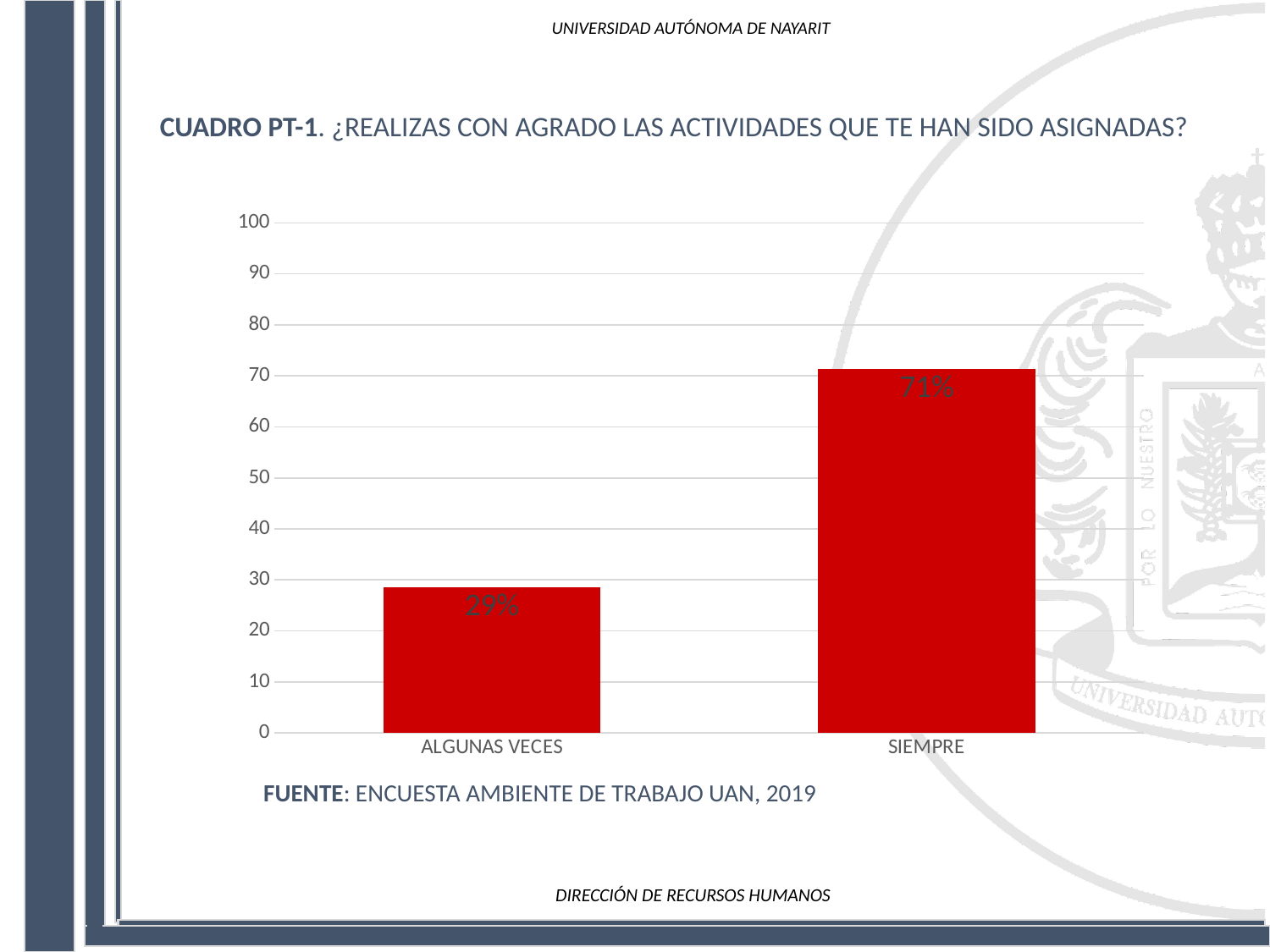
What source is cited below the chart? ENCUESTA AMBIENTE DE TRABAJO UAN, 2019 Which is larger, the value for ALGUNAS VECES or the value for SIEMPRE? SIEMPRE Which category has the lowest value? ALGUNAS VECES Is the value for ALGUNAS VECES greater or less than 40? less What is the difference between the values for SIEMPRE and ALGUNAS VECES? 42% What is the value for ALGUNAS VECES? 29% What kind of chart is shown on the slide? bar chart Which category has the highest value? SIEMPRE Is the value for SIEMPRE greater or less than 50? greater What is the maximum value shown on the vertical axis? 100 What is the value for SIEMPRE? 71% How many categories are shown on the x axis? 2